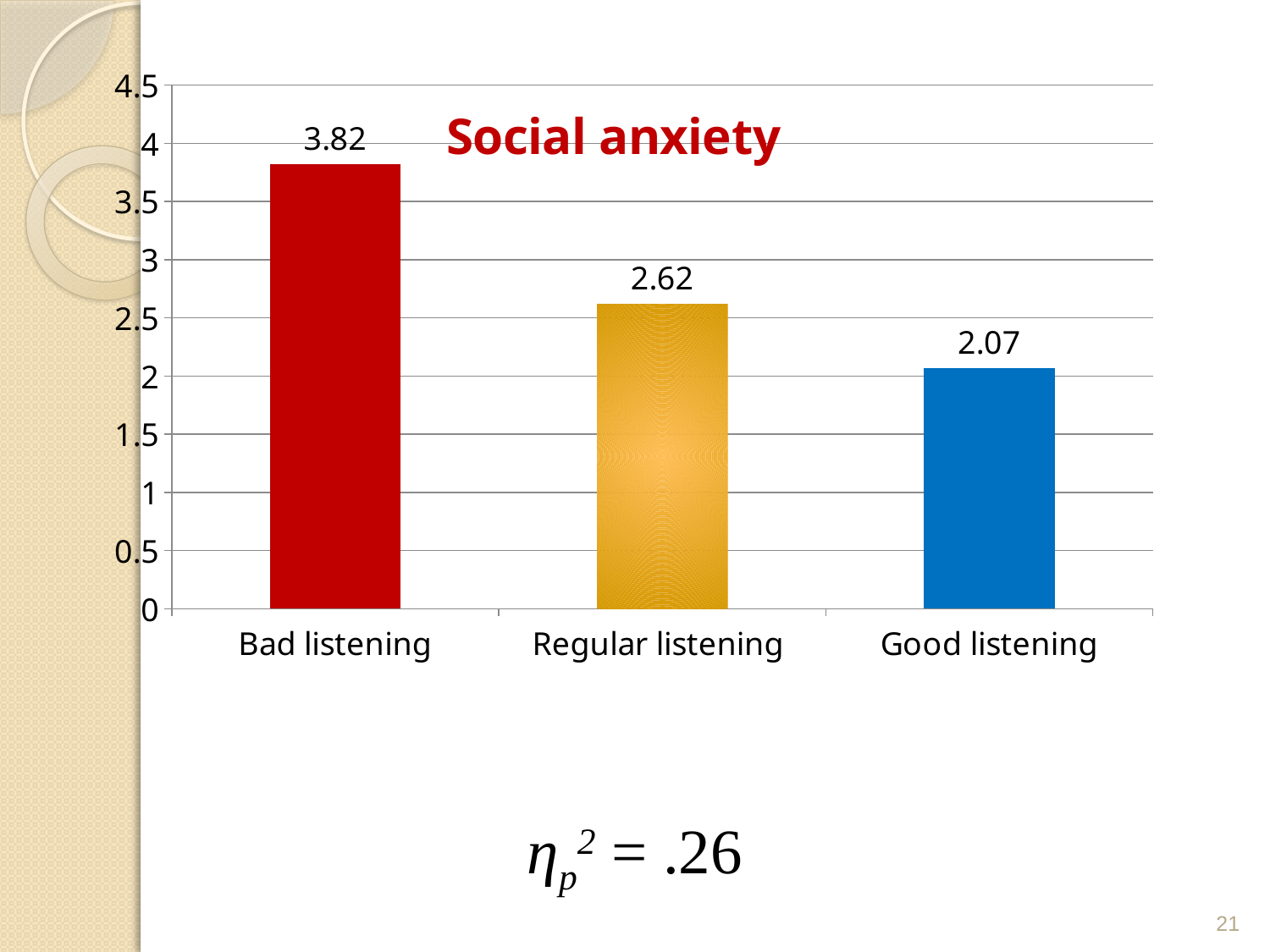
Is the value for Bad listening greater or less than 3.5? greater What is the social anxiety value for Good listening? 2.07 How many listening conditions are shown on the chart? 3 Which has a higher social anxiety value, Regular listening or Good listening? Regular listening Do the social anxiety values rise or fall from Bad listening to Good listening? Fall What kind of chart is shown on the slide? Bar chart What is the social anxiety value for Bad listening? 3.82 Which listening condition has the highest social anxiety value? Bad listening What is the difference between the social anxiety values for Bad listening and Good listening? 1.75 Which listening condition has the lowest social anxiety value? Good listening What is the difference between the social anxiety values for Regular listening and Good listening? 0.55 What is the social anxiety value for Regular listening? 2.62